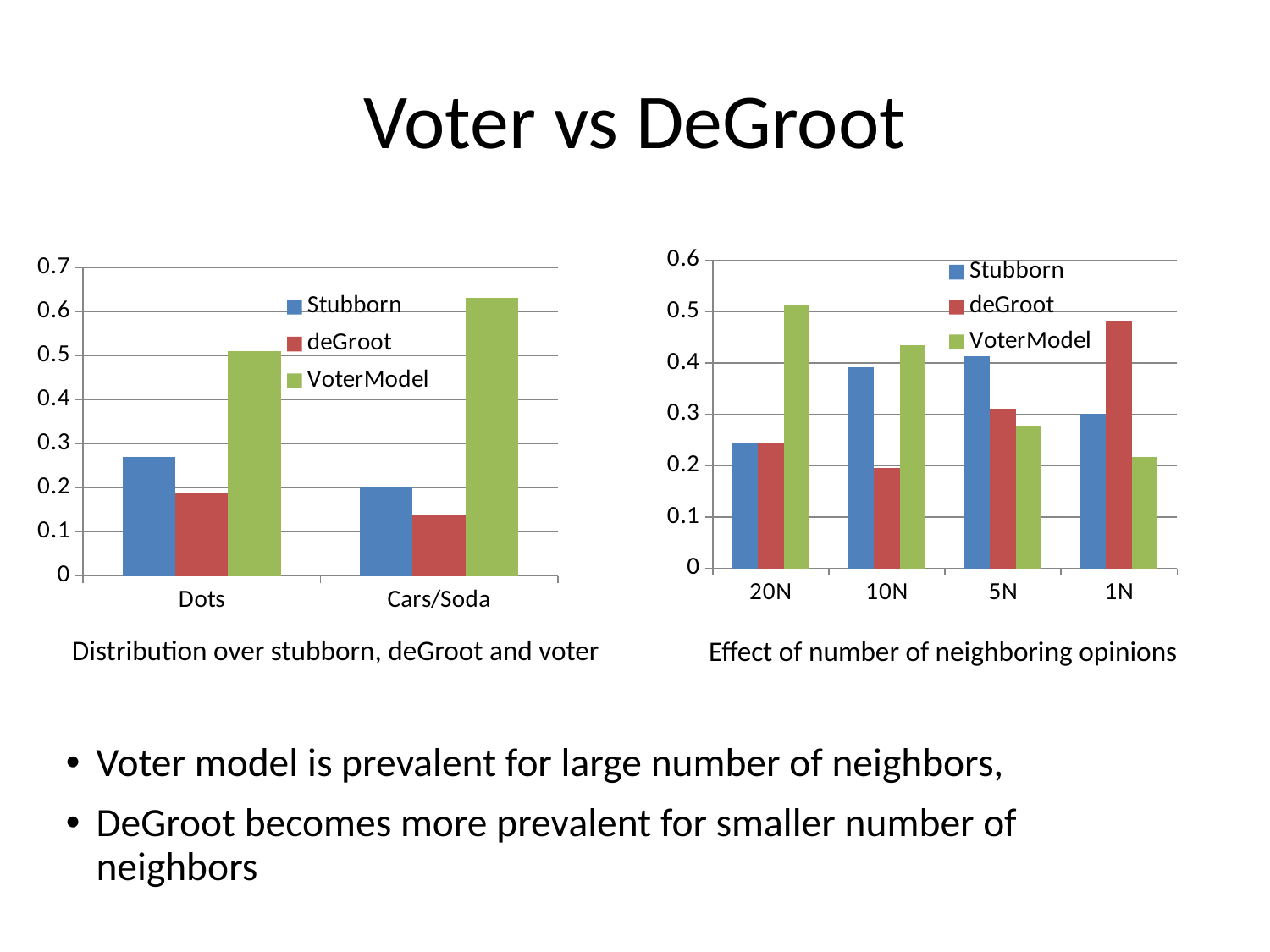
What kind of chart is the left chart, captioned 'Distribution over stubborn, deGroot and voter'? bar chart In the right chart, 'Effect of number of neighboring opinions', does the VoterModel series rise or fall from 20N to 1N? fall In the right chart, 'Effect of number of neighboring opinions', is the VoterModel value at 20N greater or less than 0.5? greater In the left chart, 'Distribution over stubborn, deGroot and voter', which series has the lowest value for Dots? deGroot How many series does the legend of the right chart, 'Effect of number of neighboring opinions', list? 3 In the left chart, 'Distribution over stubborn, deGroot and voter', which series has the highest value for Cars/Soda? VoterModel How many categories are shown on the x axis of the right chart, 'Effect of number of neighboring opinions'? 4 In the right chart, 'Effect of number of neighboring opinions', which series has the highest value at 1N? deGroot In the right chart, 'Effect of number of neighboring opinions', which is larger at 10N: Stubborn or deGroot? Stubborn What colour represents the VoterModel series in both charts? green In the left chart, 'Distribution over stubborn, deGroot and voter', is the VoterModel value for Cars/Soda greater or less than 0.6? greater